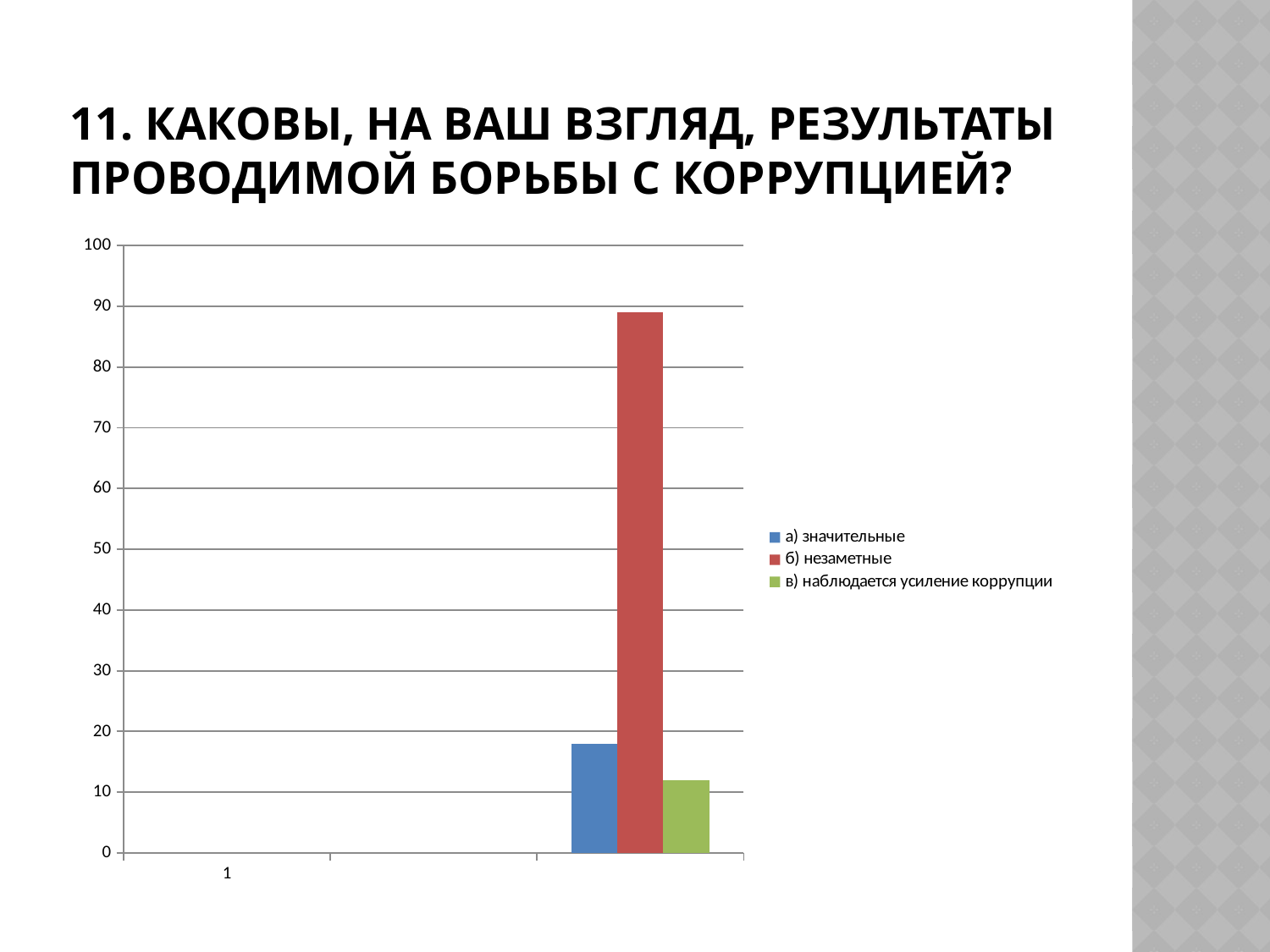
What colour is the bar for б) незаметные? red Which is larger, the value for б) незаметные or the value for а) значительные? б) незаметные Is the value for б) незаметные greater or less than 80? greater What is the highest value shown on the vertical axis? 100 Is the value for а) значительные greater or less than 10? greater How many series does the legend list? 3 Which is larger, the value for а) значительные or the value for в) наблюдается усиление коррупции? а) значительные Which series has the lowest bar? в) наблюдается усиление коррупции Is the value for а) значительные greater or less than 20? less Which series has the highest bar? б) незаметные What kind of chart is shown on the slide? bar chart